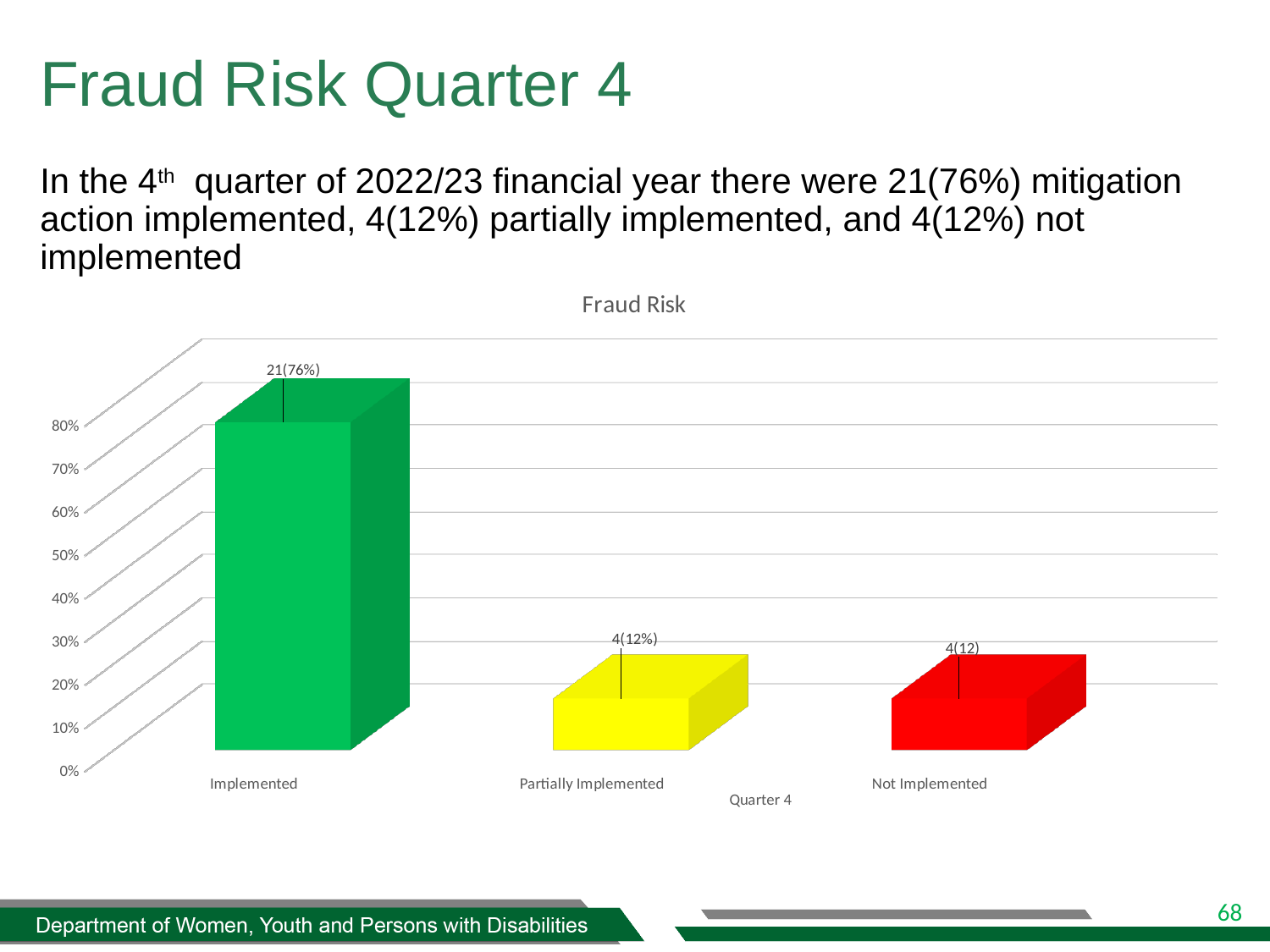
What is the data label shown for the Implemented bar? 21(76%) What is the data label shown for the Not Implemented bar? 4(12) Which category has the highest bar? Implemented How many categories are shown on the x axis? 3 What is the title of the chart? Fraud Risk Is the value for Partially Implemented greater or less than 20%? less What label appears beneath the category axis of the chart? Quarter 4 What is the data label shown for the Partially Implemented bar? 4(12%) Which is larger, the value for Implemented or the value for Not Implemented? Implemented What kind of chart is shown on the slide? Bar chart What is the difference in percentage points between the Implemented share (76%) and the Partially Implemented share (12%)? 64 Is the value for Implemented greater or less than 70%? greater